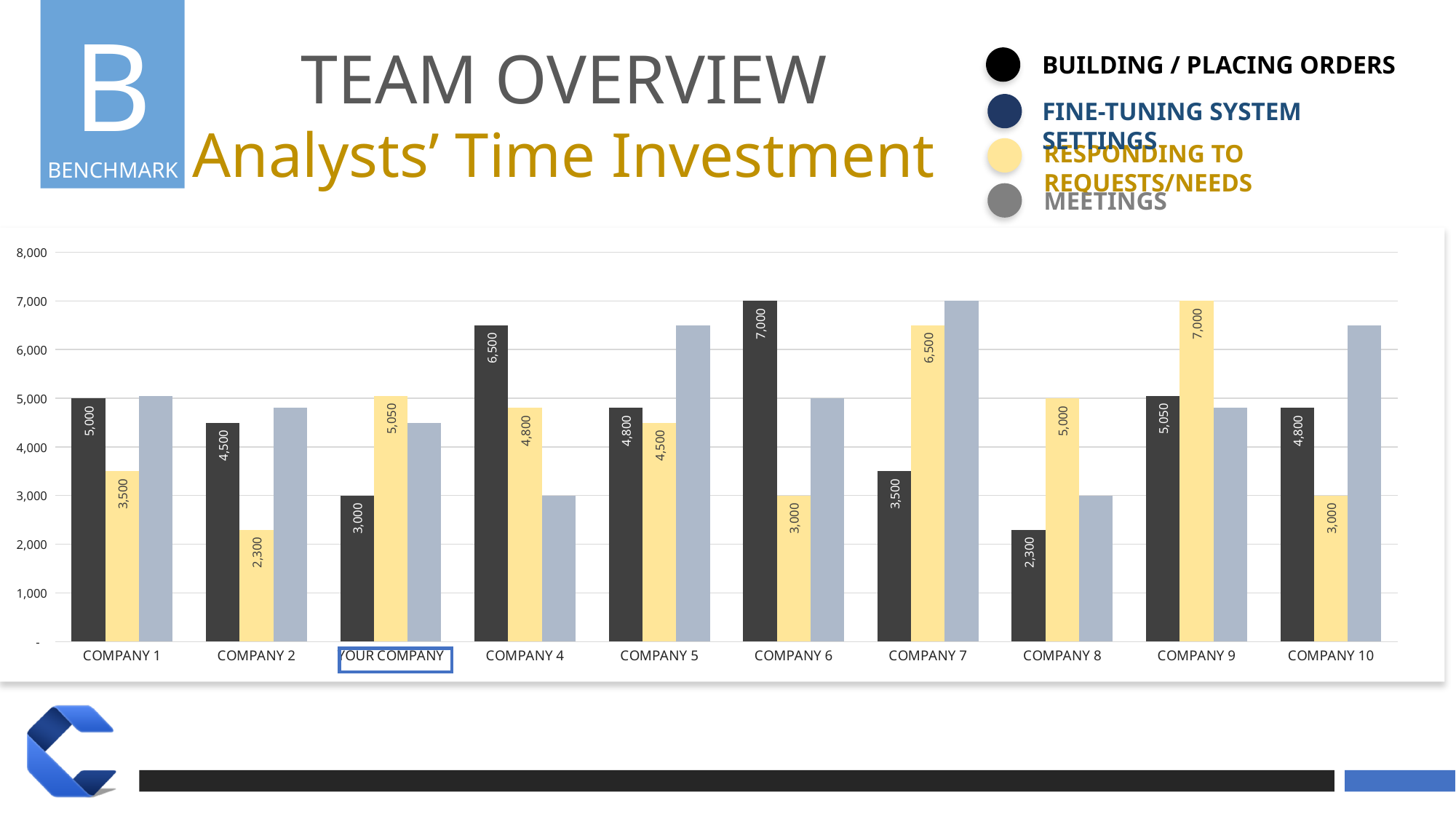
Is the Meetings bar for Company 5 greater or less than 6,000? greater How many companies are shown on the x axis? 10 What kind of chart is shown on the slide? Bar chart Which category on the x axis is highlighted with a blue box? Your Company What is the value of the Building / Placing Orders bar for Company 8? 2,300 Is the Meetings bar for Company 4 greater or less than 4,000? less What is the difference between the Building / Placing Orders value for Company 4 and for Your Company? 3,500 Which company has the lowest Building / Placing Orders value? Company 8 What is the value of the Responding to Requests/Needs bar for Your Company? 5,050 What is the value of the Building / Placing Orders bar for Company 6? 7,000 Which is larger for Company 7: the Building / Placing Orders value or the Responding to Requests/Needs value? Responding to Requests/Needs Which company has the highest Responding to Requests/Needs value? Company 9